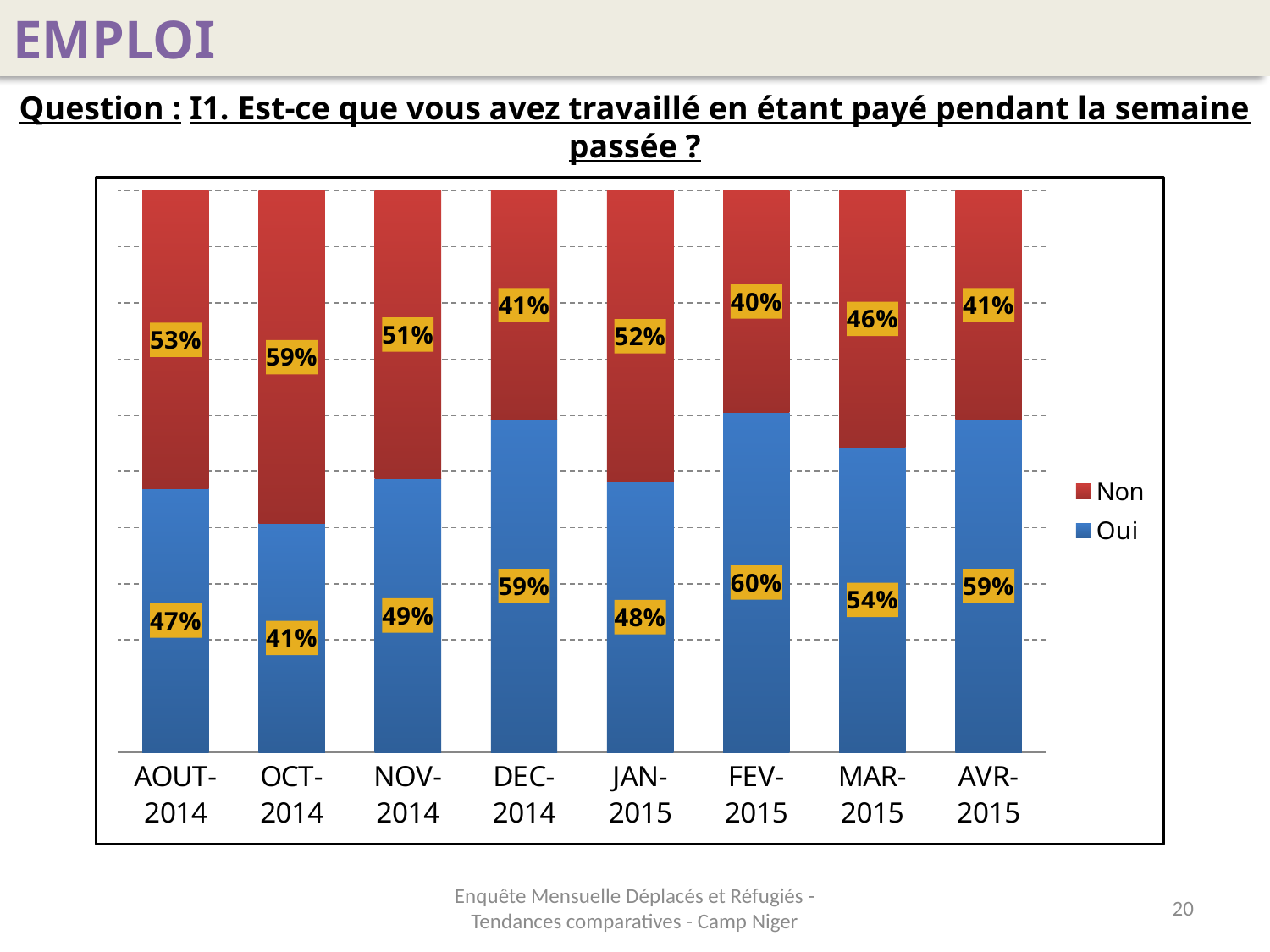
What is the difference between the "Oui" values for DEC-2014 and JAN-2015? 11 percentage points Which is larger in AOUT-2014, the "Oui" share or the "Non" share? Non In which month is the "Non" share the highest? OCT-2014 Which colour represents the "Oui" series? Blue In which month is the "Oui" share the highest? FEV-2015 What is the "Oui" value for MAR-2015? 54% What kind of chart is shown on the slide? Stacked bar chart What percentage answered "Oui" in FEV-2015? 60% In which month is the "Oui" share the lowest? OCT-2014 How many months are shown on the x axis? 8 How many series does the legend list? 2 What percentage answered "Non" in OCT-2014? 59%